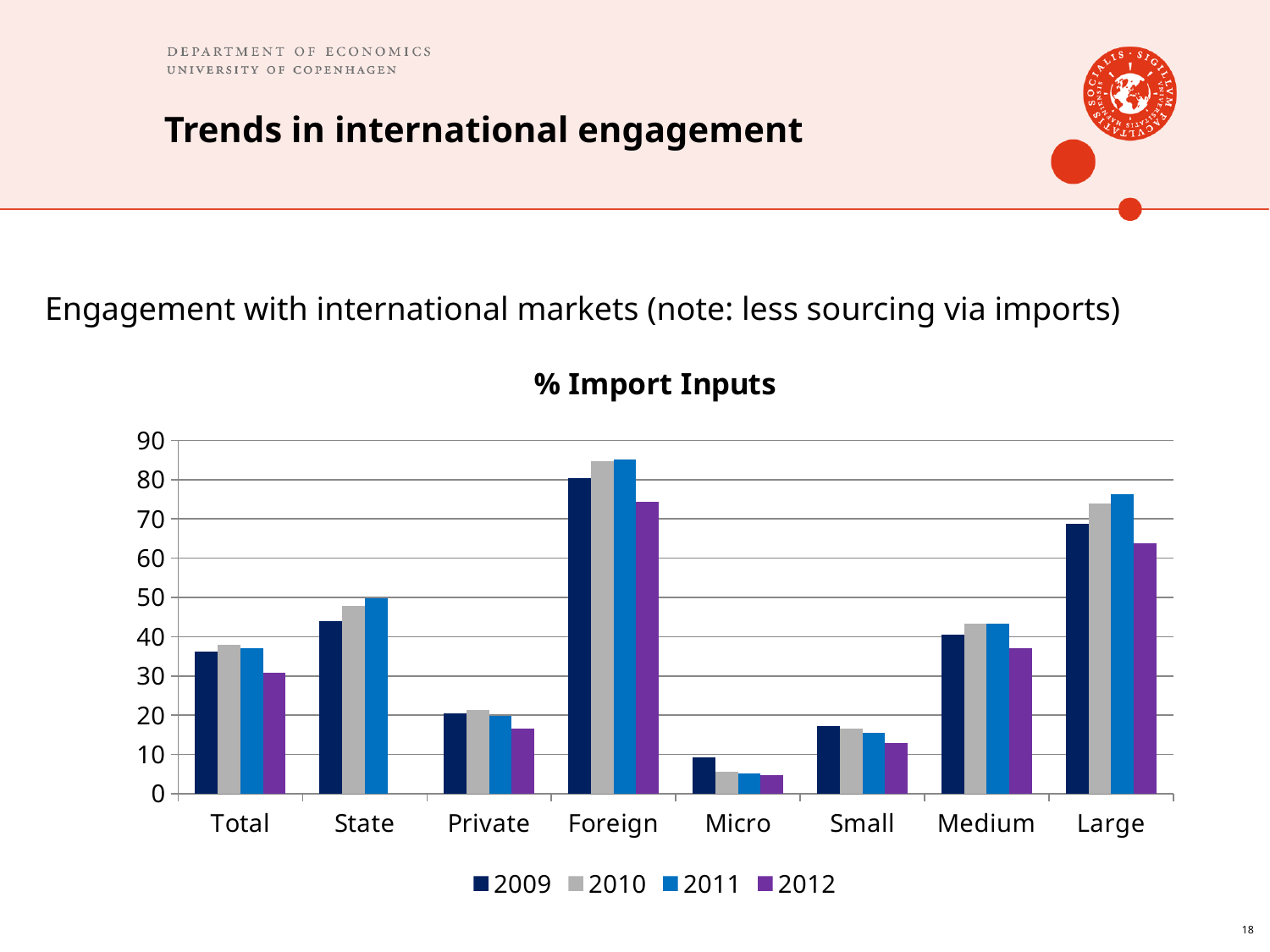
Is the value for Large in 2011 greater or less than 70? greater Which is larger, the 2011 value for State or the 2011 value for Total? State Which category has the highest value for 2011? Foreign Which is larger, the 2012 value for Large or the 2012 value for Medium? Large How many categories are shown on the x axis of the chart? 8 What kind of chart is shown on the slide? bar chart Do the 2012 values rise or fall going from Micro to Small to Medium to Large? rise What is the title of the chart? % Import Inputs How many series does the legend of the chart list? 4 Is the value for Foreign in 2010 greater or less than 80? greater Which category has the lowest value for 2012? Micro